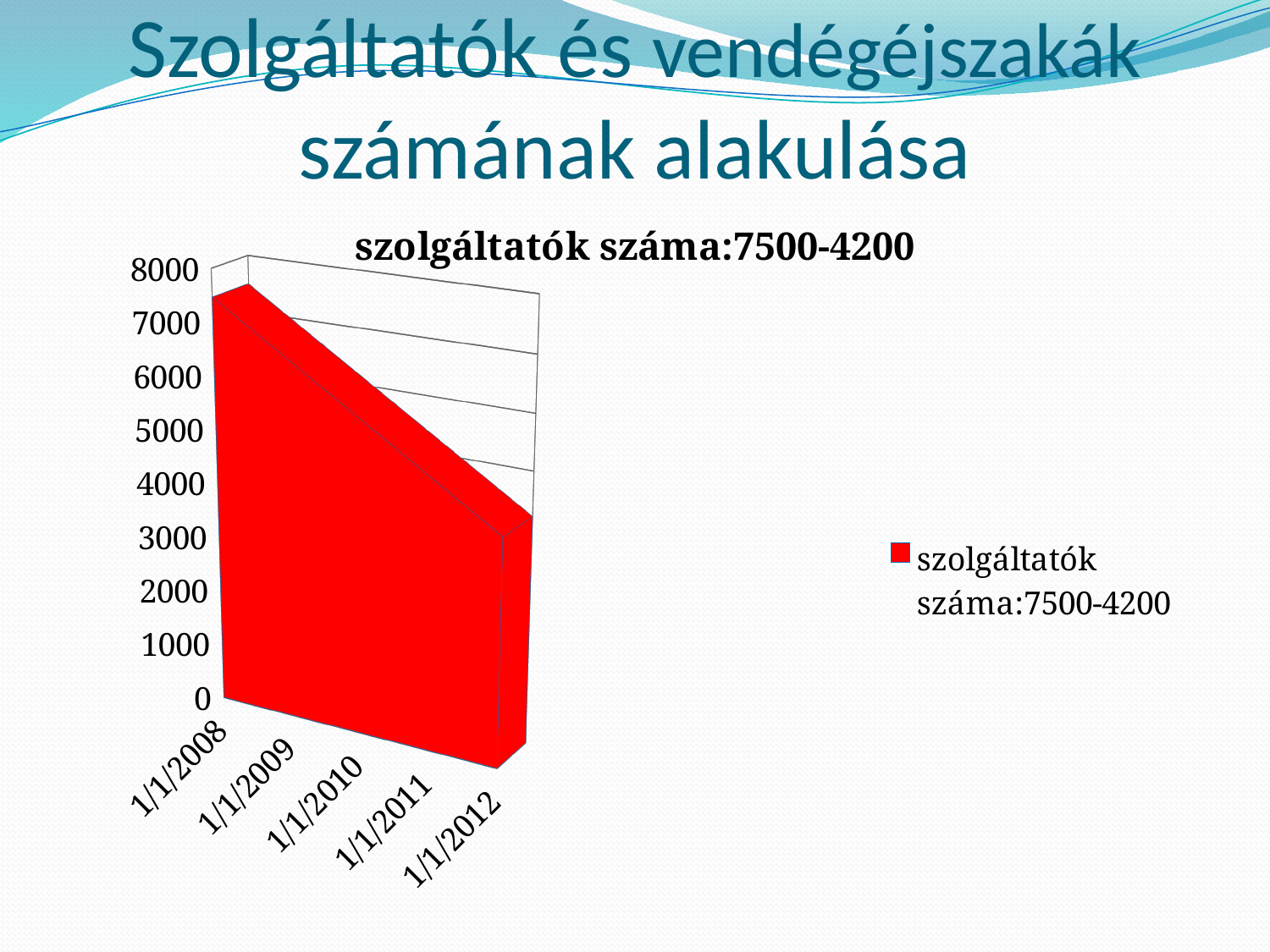
Which is larger, the value for 1/1/2008 or the value for 1/1/2012? 1/1/2008 Which date has the lowest value in the chart? 1/1/2012 Do the values rise or fall from 1/1/2008 to 1/1/2012? fall What kind of chart is shown on the slide? area chart How many series does the legend list? 1 Is the value for 1/1/2008 greater or less than 7000? greater What is the title of the chart? szolgáltatók száma:7500-4200 Is the value for 1/1/2012 greater or less than 5000? less What is the first date shown on the x axis? 1/1/2008 Which date has the highest value in the chart? 1/1/2008 What colour is the plotted area in the chart? red How many dates are shown on the x axis of the chart? 5